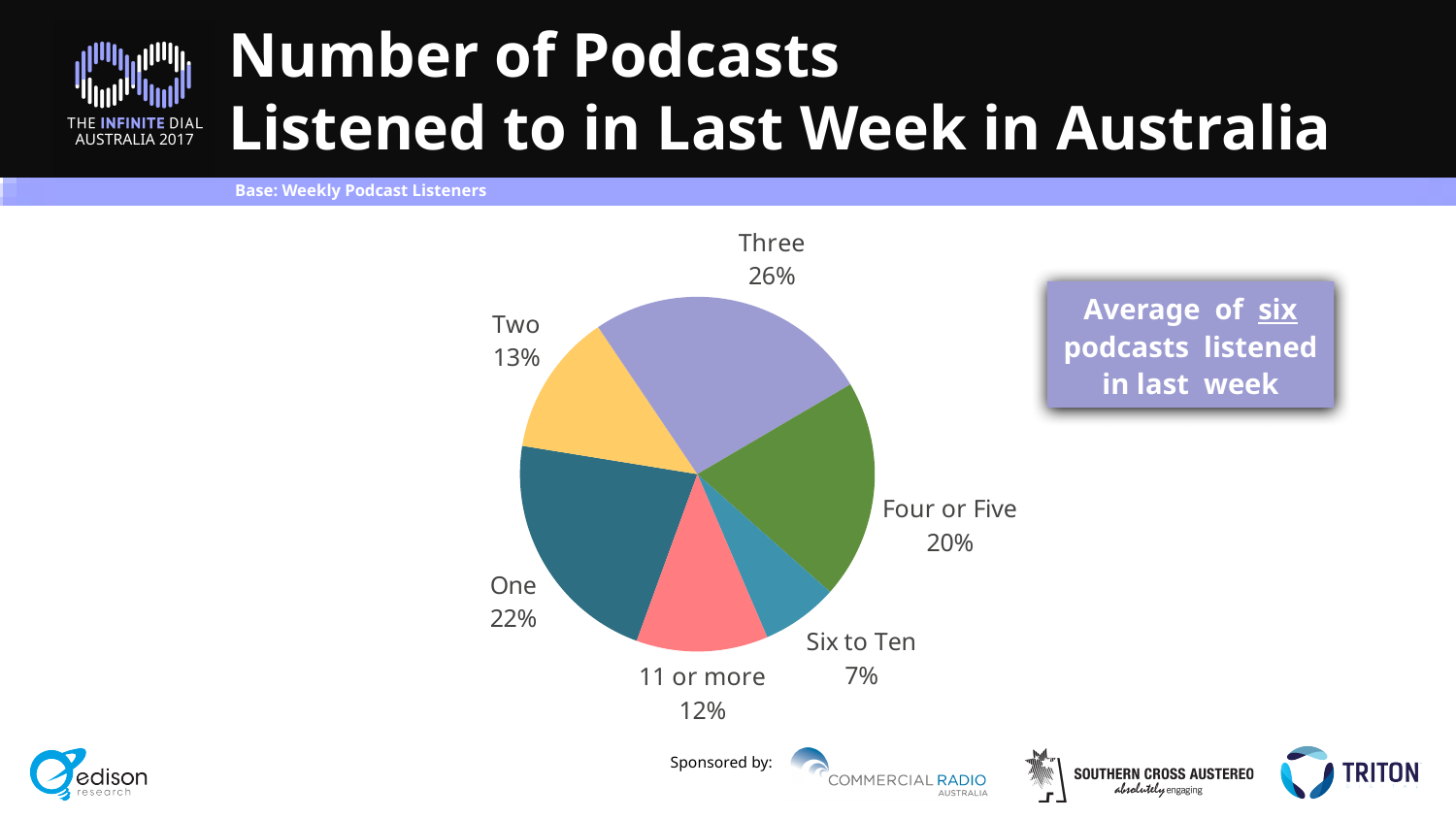
What is the difference in percentage points between the 'Three' slice and the 'Four or Five' slice? 6 What is the value for the 'One' slice? 22% Which category has the smallest share of the pie? Six to Ten According to the callout box, what is the average number of podcasts listened to in the last week? six What is the title of the chart? Number of Podcasts Listened to in Last Week in Australia Which is larger, the share for 'Two' or the share for '11 or more'? Two How many categories are shown in the pie chart? 6 Which category has the largest share of the pie? Three What share of the pie is labelled 'Six to Ten'? 7% What percentage of weekly podcast listeners listened to three podcasts in the last week? 26% What kind of chart is shown on the slide? Pie chart What is the combined share of listeners who listened to one or two podcasts? 35%